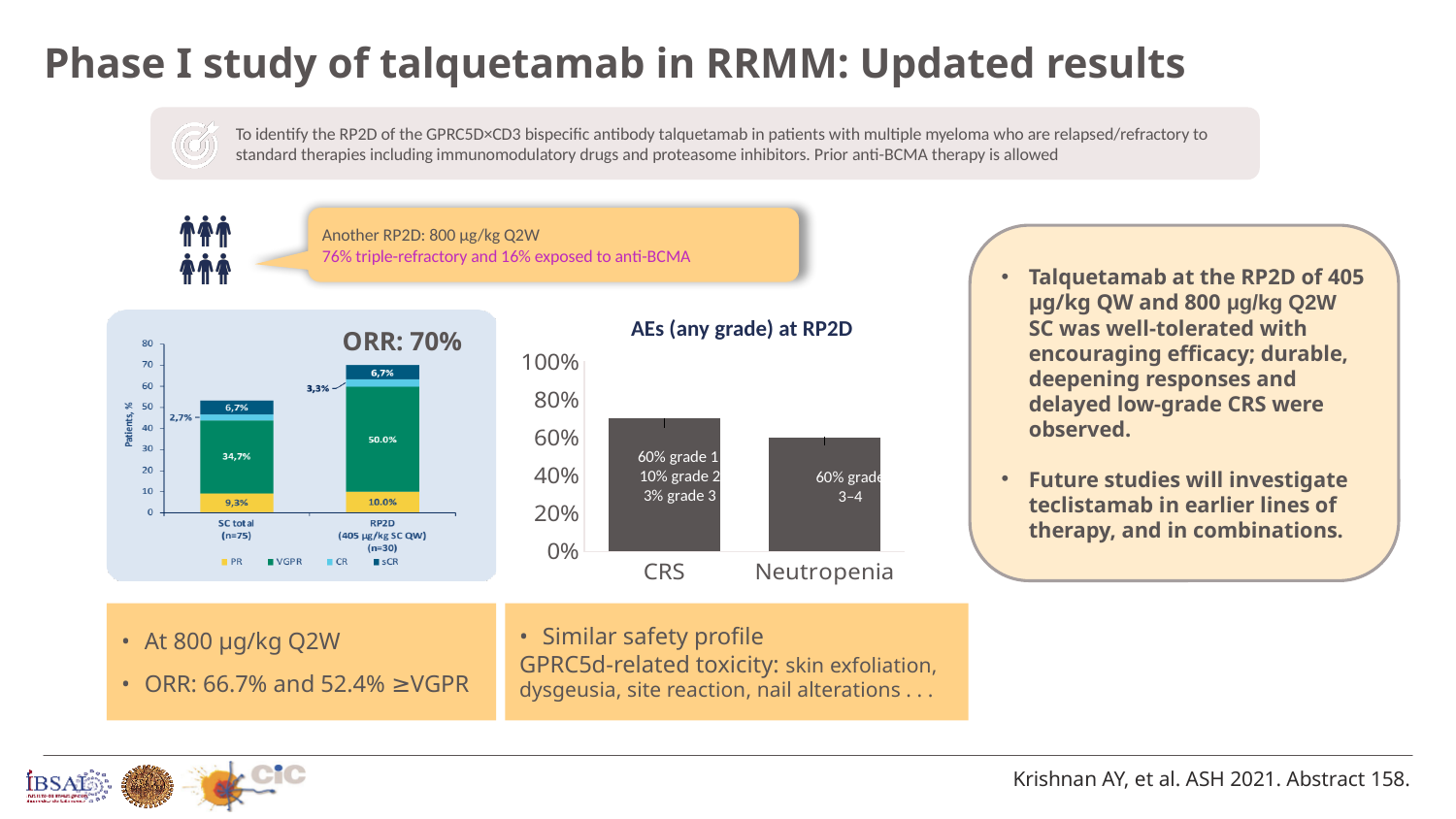
In the 'AEs (any grade) at RP2D' chart, what percentage of CRS is labelled as grade 3? 3% In the 'AEs (any grade) at RP2D' chart, what kind of chart is shown? bar chart In the ORR chart on the left, what is the CR value for the RP2D (405 µg/kg SC QW) group? 3,3% In the ORR chart on the left, how many series does the legend list? 4 In the 'AEs (any grade) at RP2D' chart, is the value for CRS greater or less than 60%? greater In the ORR chart on the left, what is the VGPR value for the RP2D (405 µg/kg SC QW) group? 50.0% In the 'AEs (any grade) at RP2D' chart, how many categories are shown on the x axis? 2 In the ORR chart on the left, what is the PR value for the SC total (n=75) group? 9,3% In the 'AEs (any grade) at RP2D' chart, what percentage of CRS is labelled as grade 1? 60% In the 'AEs (any grade) at RP2D' chart, is the value for Neutropenia greater or less than 80%? less In the 'AEs (any grade) at RP2D' chart, which category has the taller bar, CRS or Neutropenia? CRS In the ORR chart on the left, what is the VGPR value for the SC total (n=75) group? 34,7%